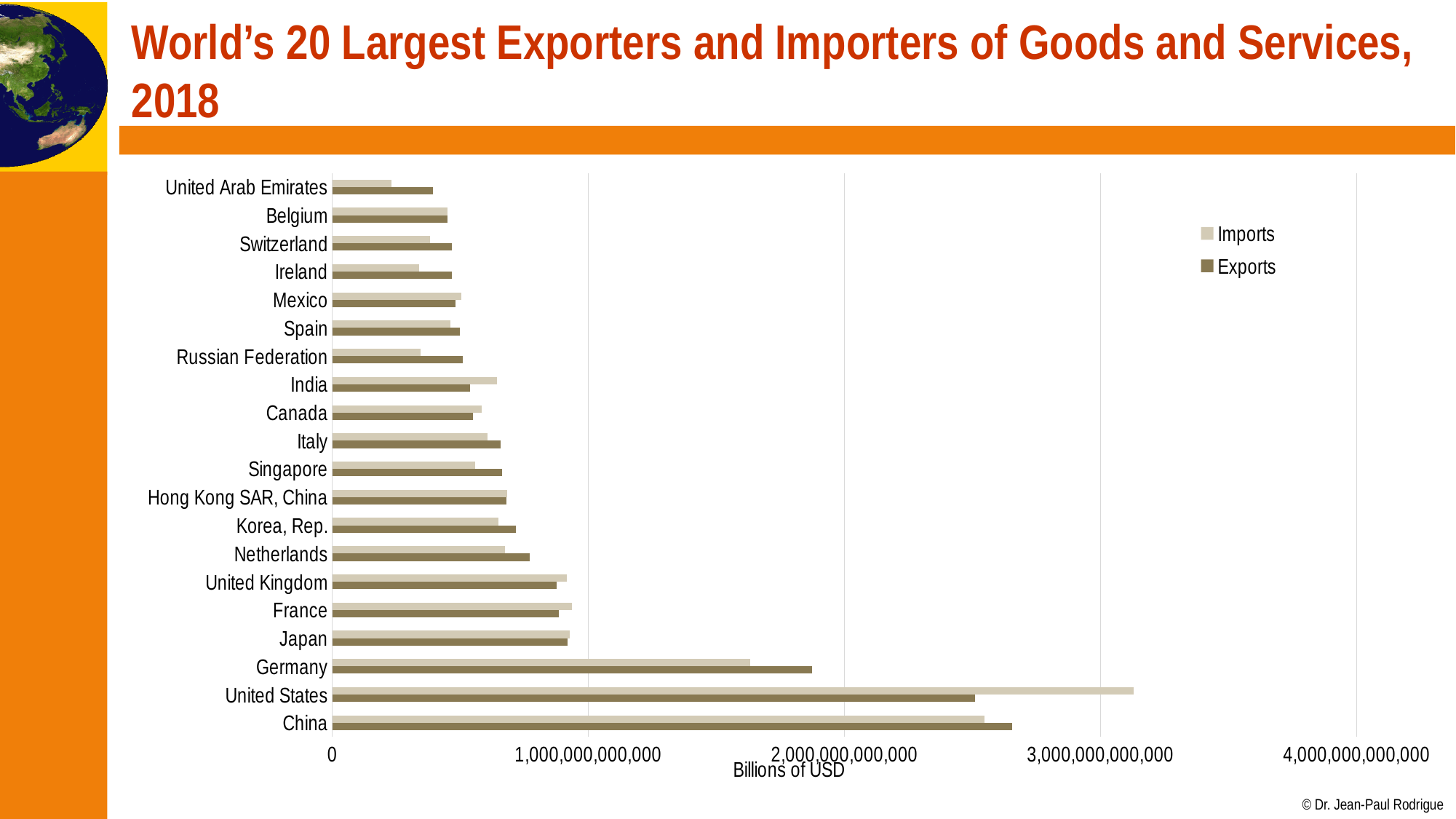
What kind of chart is shown on the slide? Bar chart What is the label on the horizontal axis? Billions of USD How many series does the legend list? 2 For Germany, which is larger: Imports or Exports? Exports Which country has the highest Imports value? United States Is the Exports value for China greater or less than 2,000,000,000,000? greater Which country has the highest Exports value? China How many countries are shown on the chart? 20 For the United States, which is larger: Imports or Exports? Imports Is the Imports value for the United States greater or less than 3,000,000,000,000? greater Which country has the lowest Imports value? United Arab Emirates Is the Exports value for Germany greater or less than 2,000,000,000,000? less